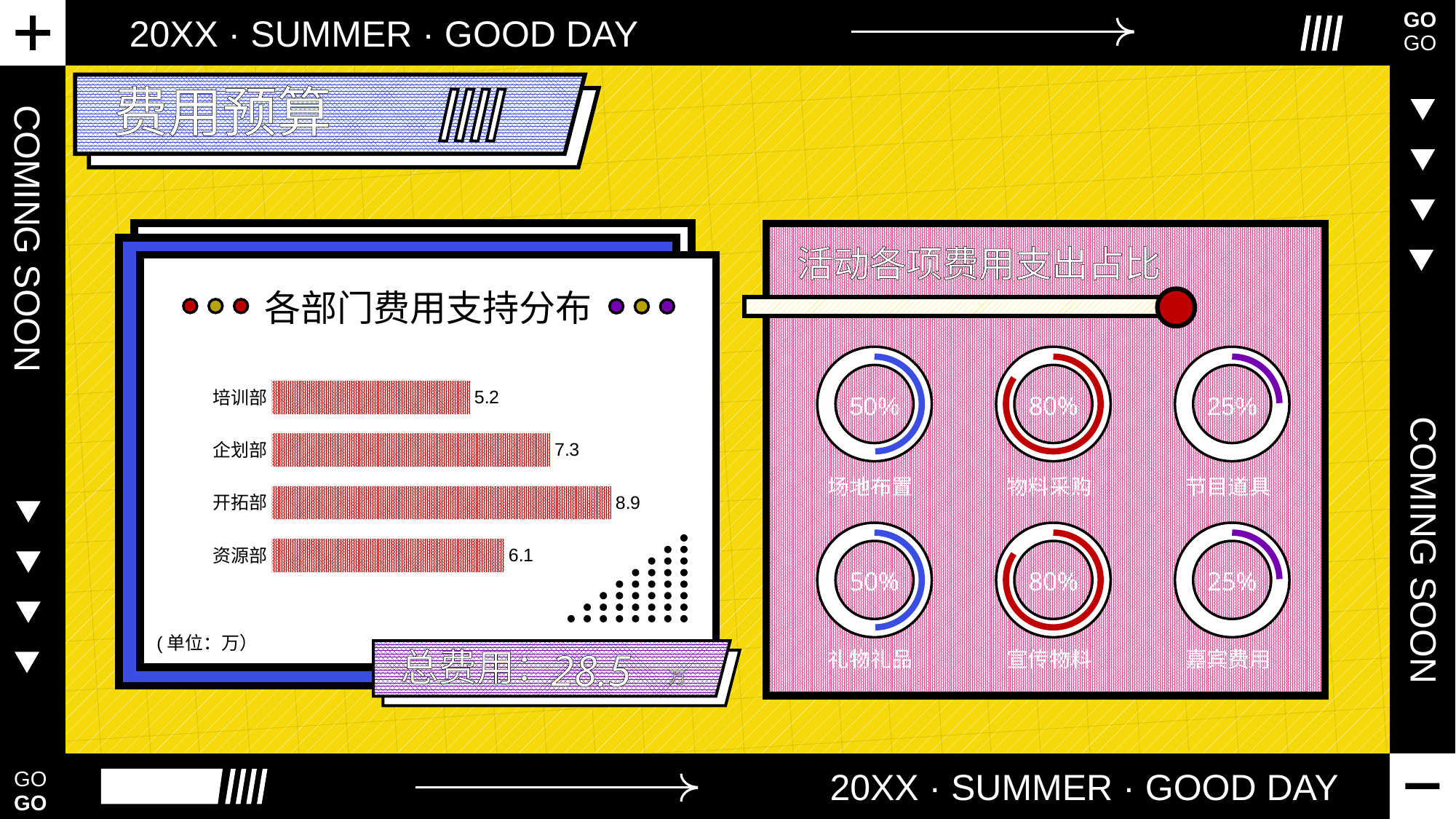
How many ring charts are shown under 活动各项费用支出占比? 6 In the bar chart 各部门费用支持分布, which is larger, 企划部 or 资源部? 企划部 In the bar chart 各部门费用支持分布, what is the difference between 开拓部 and 培训部? 3.7 In the bar chart 各部门费用支持分布, what is the value for 企划部? 7.3 In the ring charts under 活动各项费用支出占比, what percentage is shown for 物料采购? 80% What type of chart is 各部门费用支持分布? bar chart In the bar chart 各部门费用支持分布, which department has the highest value? 开拓部 In the bar chart 各部门费用支持分布, what is the value for 资源部? 6.1 In the bar chart 各部门费用支持分布, which department has the lowest value? 培训部 What unit is stated for the values in the bar chart 各部门费用支持分布? 万 In the ring charts under 活动各项费用支出占比, what percentage is shown for 嘉宾费用? 25% How many departments are shown in the bar chart 各部门费用支持分布? 4